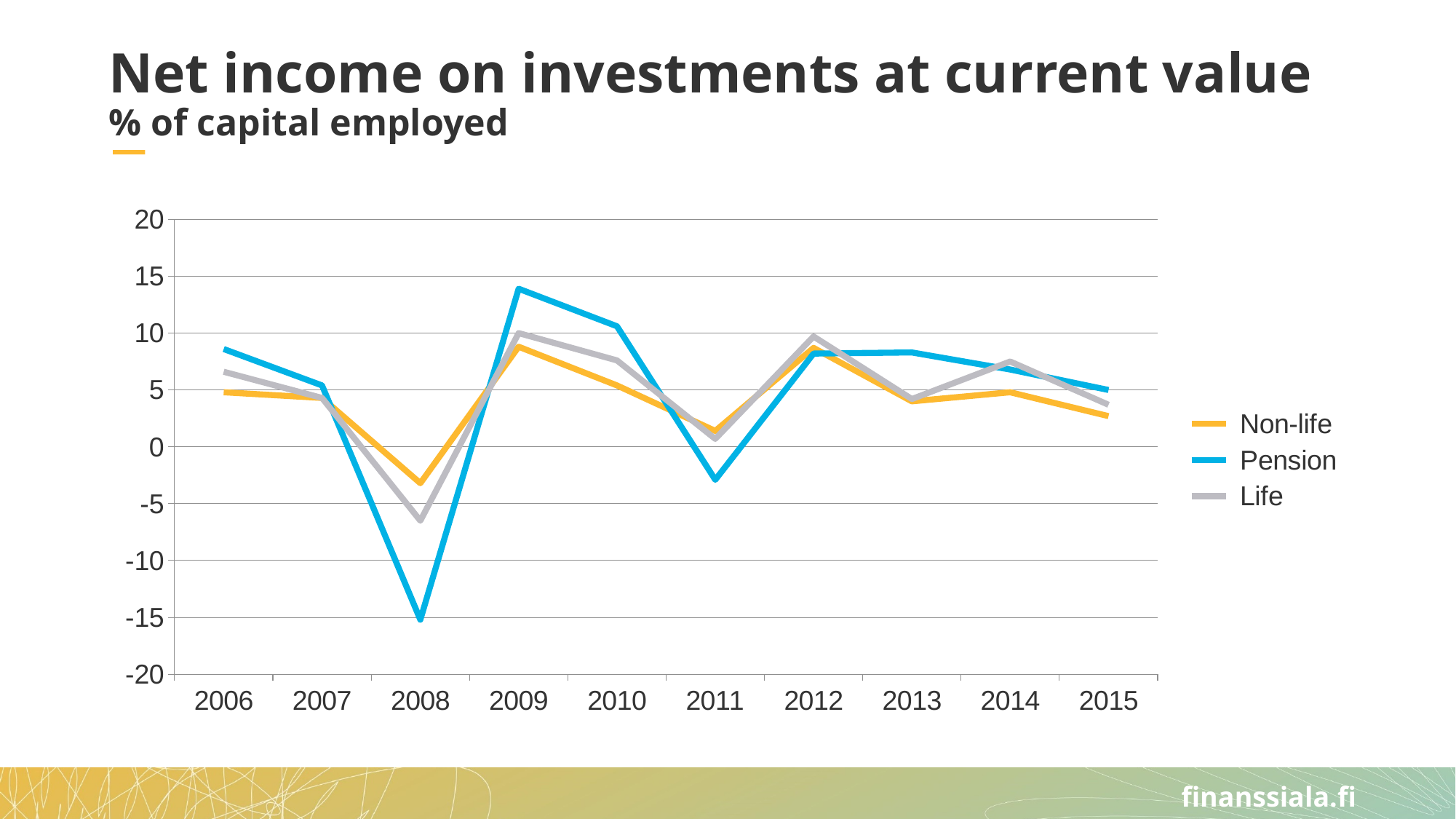
How many series does the legend list? 3 Is the value for Pension in 2008 greater or less than -10? less How many years are shown on the x axis? 10 In which year is the Pension series at its lowest? 2008 In which year is the Pension series at its highest? 2009 What kind of chart is shown on the slide? line chart In 2008, which is larger: the Pension value or the Non-life value? Non-life Is the value for Non-life in 2008 greater or less than 0? less In 2010, which is larger: the Pension value or the Life value? Pension Does the Pension series rise or fall from 2013 to 2015? fall Is the value for Pension in 2009 greater or less than 10? greater What colour is the Pension line in the legend? blue